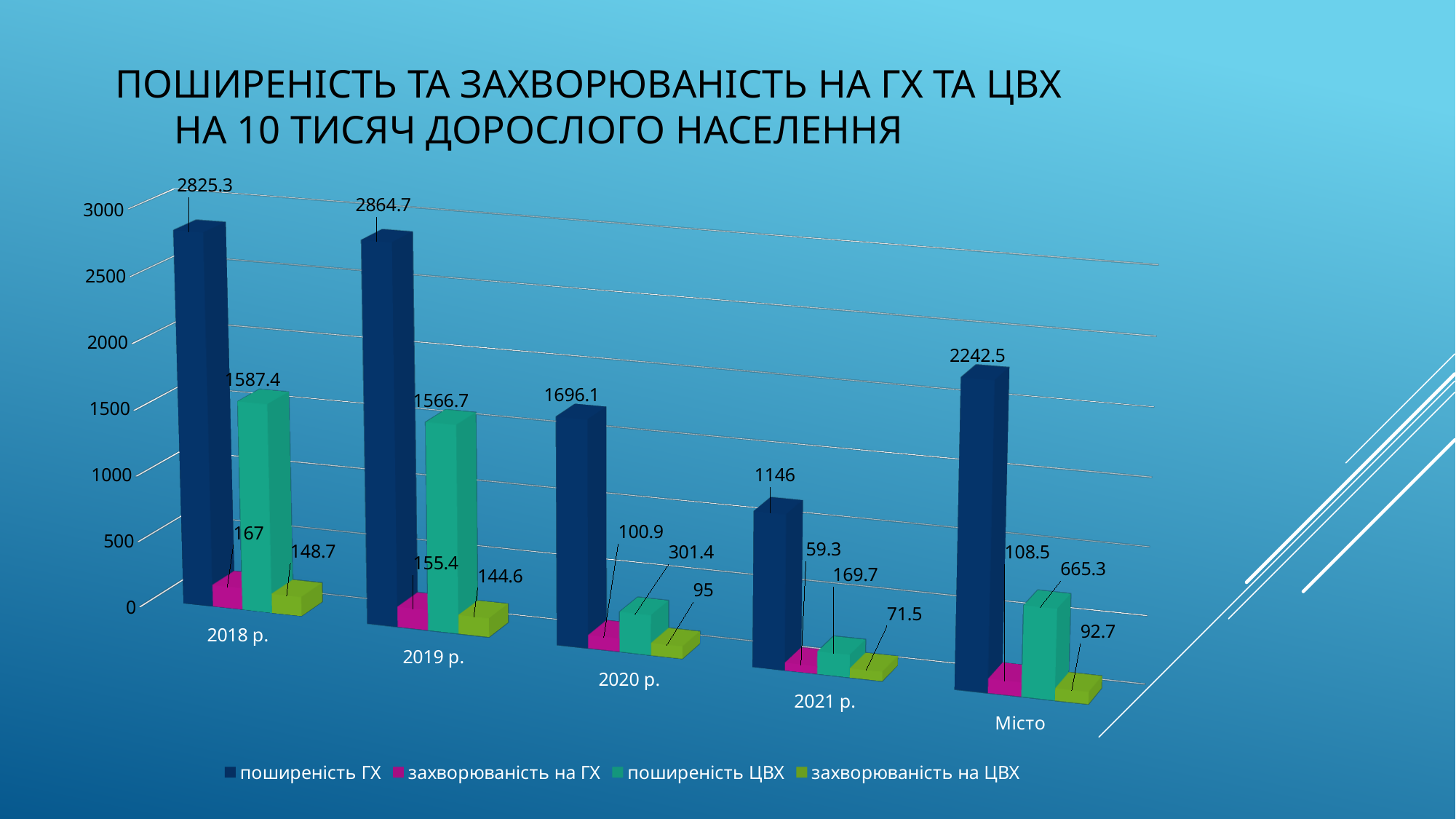
What is the value of захворюваність на ГХ for 2021 р.? 59.3 What is the difference between поширеність ГХ for 2018 р. and 2021 р.? 1679.3 How many categories are shown on the x axis? 5 What is the value of поширеність ЦВХ for Місто? 665.3 What is the value of поширеність ГХ for 2018 р.? 2825.3 What kind of chart is shown on the slide? Bar chart Which category has the lowest value for поширеність ЦВХ? 2021 р. How many series does the legend list? 4 Is the value of поширеність ГХ for Місто greater or less than 2000? greater Which is larger: захворюваність на ГХ for 2018 р. or for 2019 р.? 2018 р. Which category has the highest value for поширеність ГХ? 2019 р. What is the value of захворюваність на ЦВХ for 2020 р.? 95